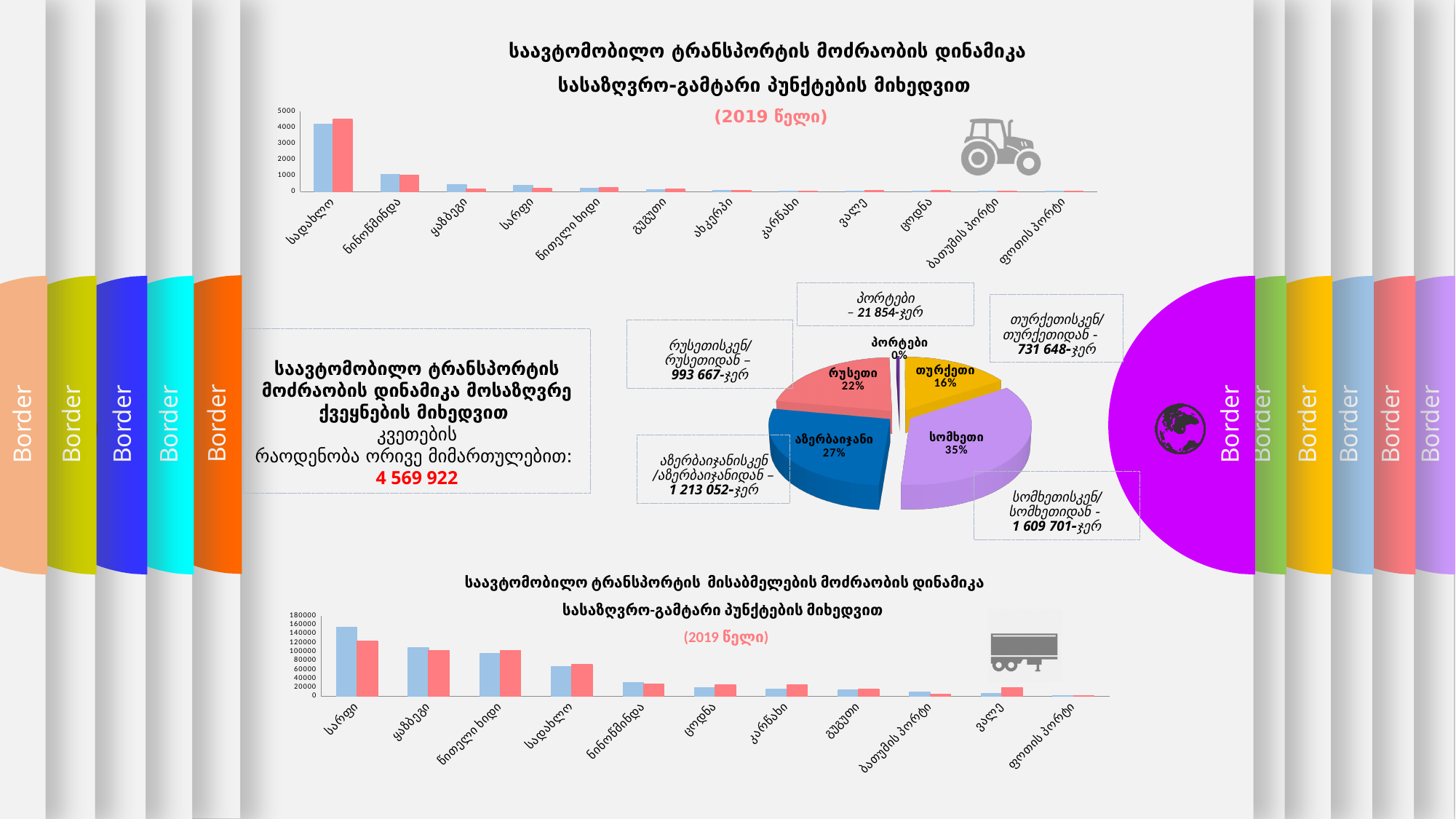
In the pie chart in the middle of the slide, what share does რუსეთი have? 22% In the pie chart in the middle of the slide, what value is given in the callout for სომხეთი? 1 609 701-ჯერ How many categories are shown on the x axis of the bar chart at the top of the slide? 12 In the pie chart in the middle of the slide, which slice is the smallest? პორტები In the bar chart at the bottom of the slide, is the blue bar for სარფი greater or less than 140000? greater In the pie chart in the middle of the slide, how many slices are there? 5 In the pie chart in the middle of the slide, what share does სომხეთი have? 35% In the bar chart at the top of the slide, which category has the highest bars? სადახლო In the pie chart in the middle of the slide, what share does აზერბაიჯანი have? 27% In the pie chart in the middle of the slide, what value is given in the callout for თურქეთი? 731 648-ჯერ In the pie chart in the middle of the slide, which slice is the largest? სომხეთი What kind of chart is the chart at the top of the slide? bar chart